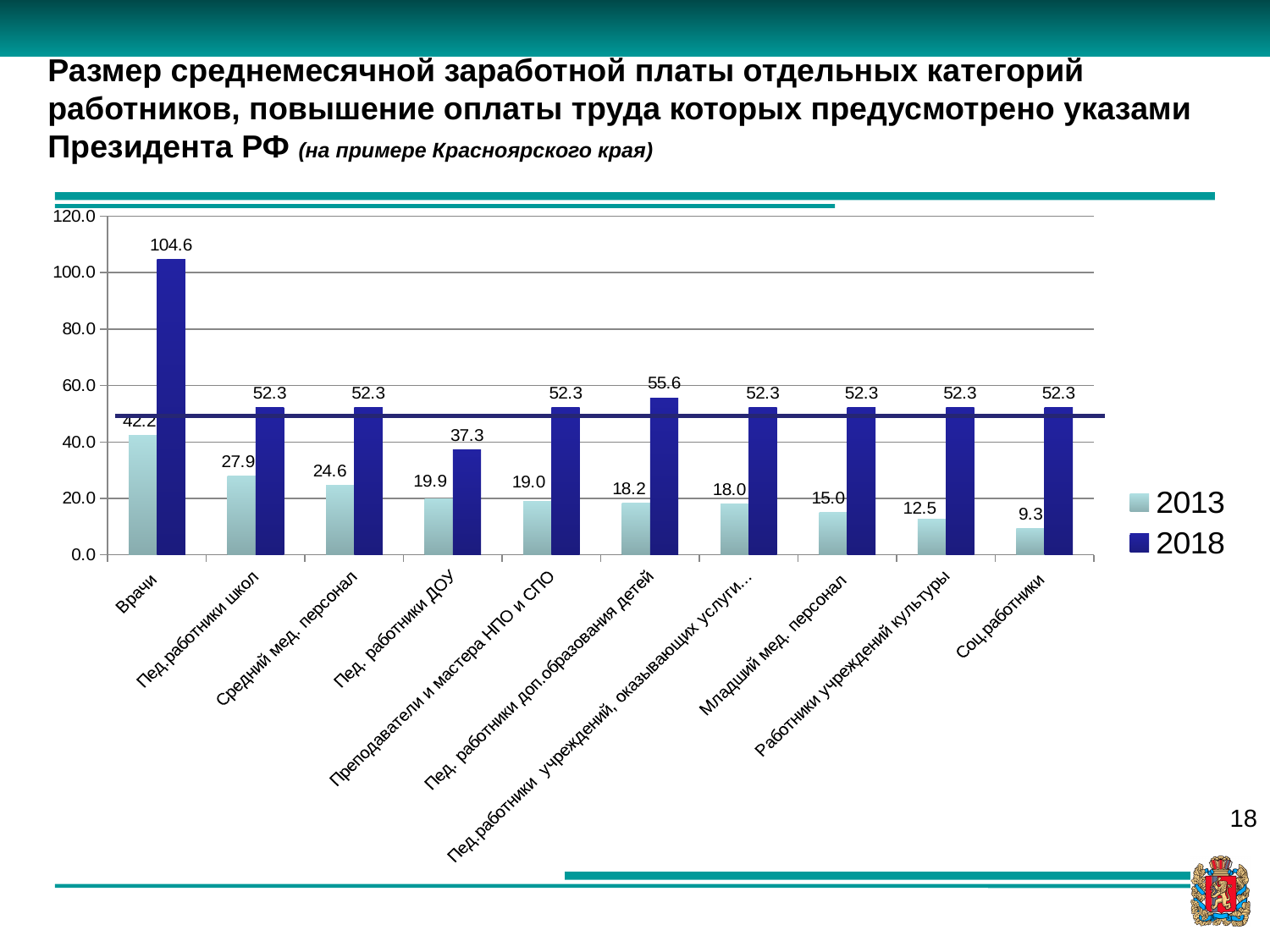
What is the 2018 value for Пед. работники ДОУ? 37.3 What is the 2018 value for Врачи? 104.6 What kind of chart is shown on the slide? Bar chart Which category has the lowest 2013 value? Соц.работники What is the 2013 value for Соц.работники? 9.3 Do the 2013 values rise or fall from left to right along the x axis? Fall What is the 2013 value for Средний мед. персонал? 24.6 What is the difference between the 2018 and 2013 values for Врачи? 62.4 Which is larger: the 2018 value for Пед. работники доп.образования детей or the 2018 value for Пед.работники школ? Пед. работники доп.образования детей Which category has the highest 2018 value? Врачи How many series does the legend list? 2 How many categories are shown on the x axis? 10